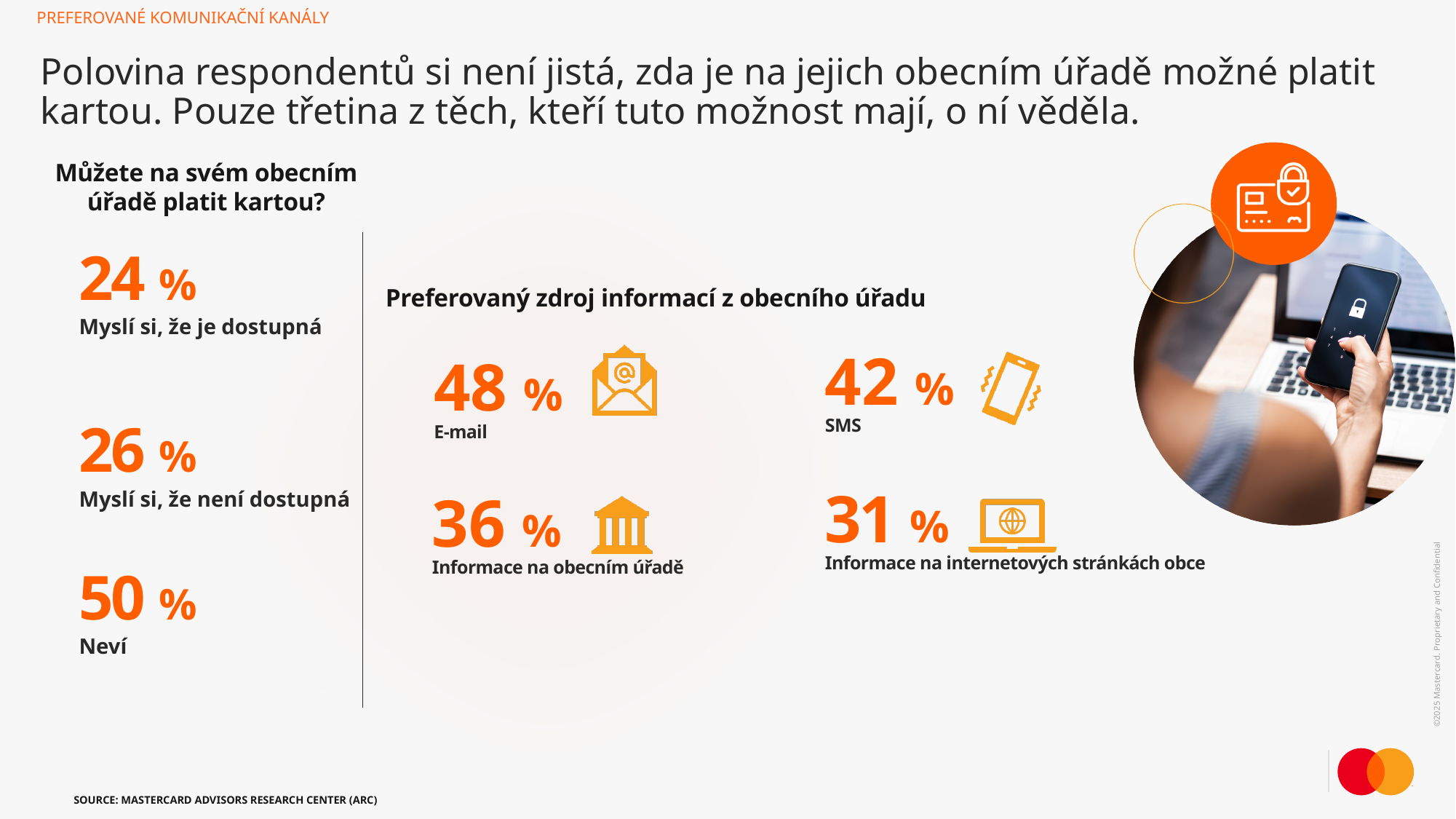
In the section "Můžete na svém obecním úřadě platit kartou?", which answer has the highest share? Neví In the section "Preferovaný zdroj informací z obecního úřadu", what share of respondents prefer E-mail? 48 % In the section "Můžete na svém obecním úřadě platit kartou?", what share of respondents think card payment is not available ("Myslí si, že není dostupná")? 26 % In the section "Můžete na svém obecním úřadě platit kartou?", what share of respondents think card payment is available ("Myslí si, že je dostupná")? 24 % In the section "Můžete na svém obecním úřadě platit kartou?", which answer has the lowest share? Myslí si, že je dostupná In the section "Můžete na svém obecním úřadě platit kartou?", what share of respondents answered "Neví"? 50 % In the section "Preferovaný zdroj informací z obecního úřadu", which is larger: the share for SMS or the share for "Informace na obecním úřadě"? SMS In the section "Můžete na svém obecním úřadě platit kartou?", how many answer options are shown? 3 In the section "Preferovaný zdroj informací z obecního úřadu", what share of respondents prefer SMS? 42 % In the section "Preferovaný zdroj informací z obecního úřadu", what share of respondents prefer "Informace na internetových stránkách obce"? 31 % In the section "Preferovaný zdroj informací z obecního úřadu", which information source has the lowest share? Informace na internetových stránkách obce In the section "Preferovaný zdroj informací z obecního úřadu", what is the difference in percentage points between E-mail and "Informace na obecním úřadě"? 12